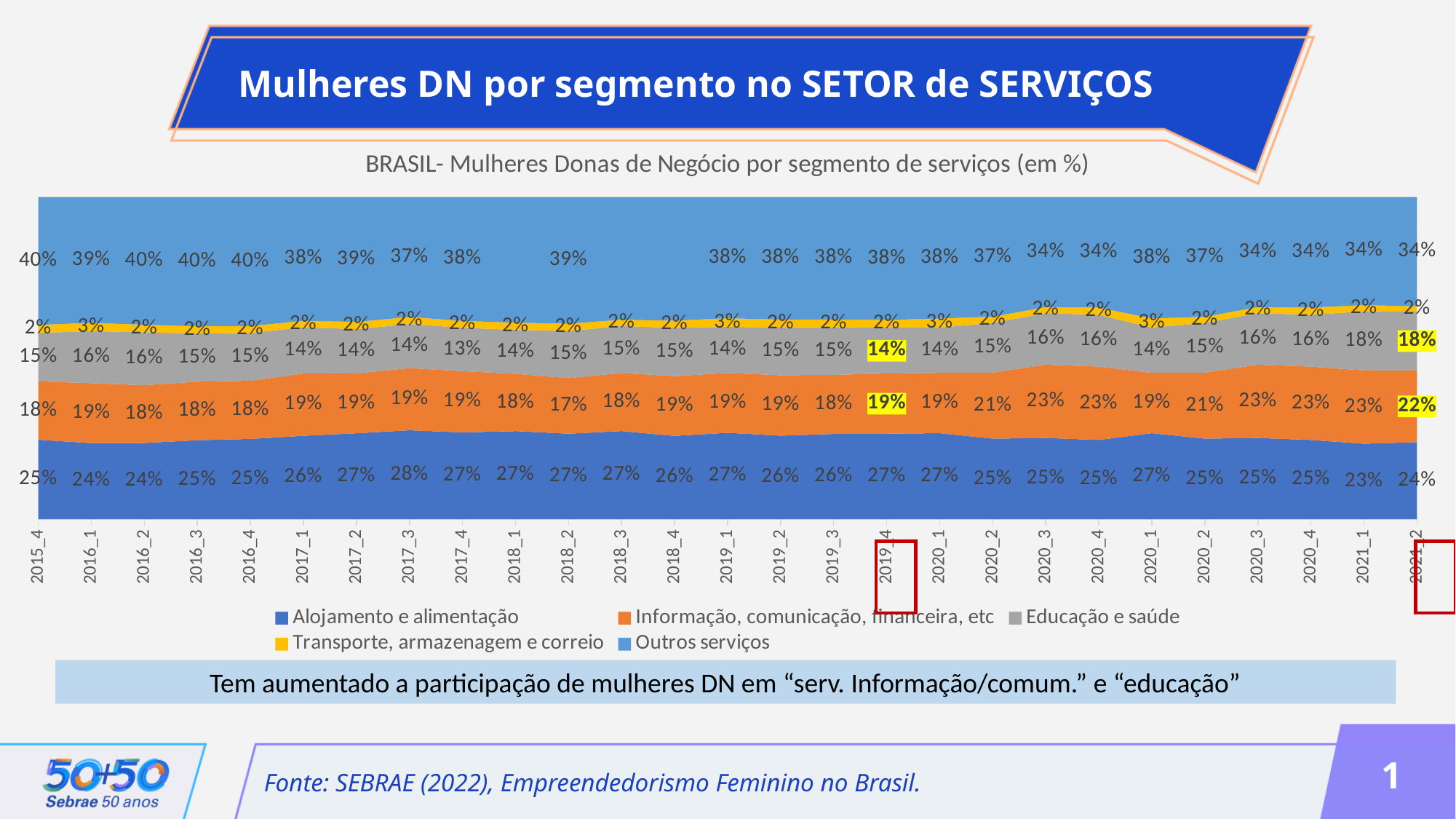
At 2021_2, which segment has the lowest share? Transporte, armazenagem e correio What is the value for "Outros serviços" at 2015_4? 40% What is the value for "Informação, comunicação, financeira, etc" at 2021_2? 22% At 2021_2, which segment has the highest share? Outros serviços How many series does the legend list? 5 By how many percentage points did "Informação, comunicação, financeira, etc" change from 2019_4 to 2021_2? 3 percentage points What is the value for "Alojamento e alimentação" at 2015_4? 25% At 2021_2, which is larger: "Alojamento e alimentação" or "Informação, comunicação, financeira, etc"? Alojamento e alimentação Does the share of "Outros serviços" rise or fall from 2015_4 to 2021_2? Fall In which period does "Alojamento e alimentação" reach its highest value, and what is it? 2017_3, 28% What kind of chart is shown on the slide? Stacked area chart What is the value for "Educação e saúde" at 2021_2? 18%